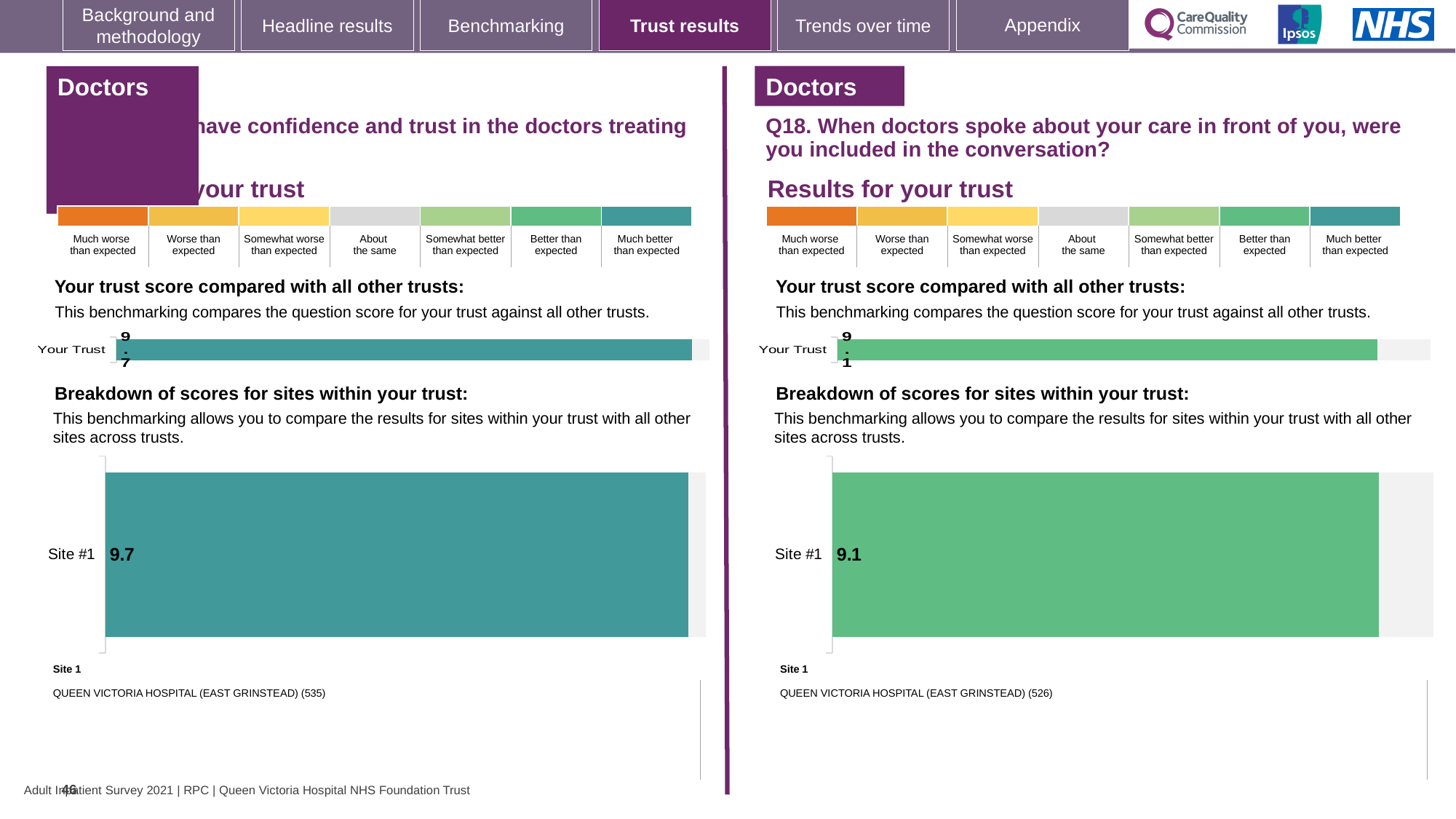
On the left half of the slide, what is the score shown for Your Trust in the 'Your trust score compared with all other trusts' chart? 9.7 Which site name is listed under Site 1 in the left breakdown chart? QUEEN VICTORIA HOSPITAL (EAST GRINSTEAD) (535) In the left 'Breakdown of scores for sites within your trust' chart, what is the score for Site #1? 9.7 What type of chart is used to show the Your Trust score on the left half of the slide? Bar chart How many sites are shown in the left 'Breakdown of scores for sites within your trust' chart? 1 What is the difference between the Your Trust score on the left half of the slide and the Your Trust score on the right (Q18) half? 0.6 In the right (Q18) 'Breakdown of scores for sites within your trust' chart, what is the score for Site #1? 9.1 On the right half of the slide (Q18), what is the score shown for Your Trust in the 'Your trust score compared with all other trusts' chart? 9.1 Which is larger: the Site #1 score in the left breakdown chart or the Site #1 score in the right (Q18) breakdown chart? The left chart (9.7) What type of chart is used to show the Site #1 score on the right (Q18) half of the slide? Bar chart Which site name is listed under Site 1 in the right (Q18) breakdown chart? QUEEN VICTORIA HOSPITAL (EAST GRINSTEAD) (526) How many sites are shown in the right (Q18) 'Breakdown of scores for sites within your trust' chart? 1